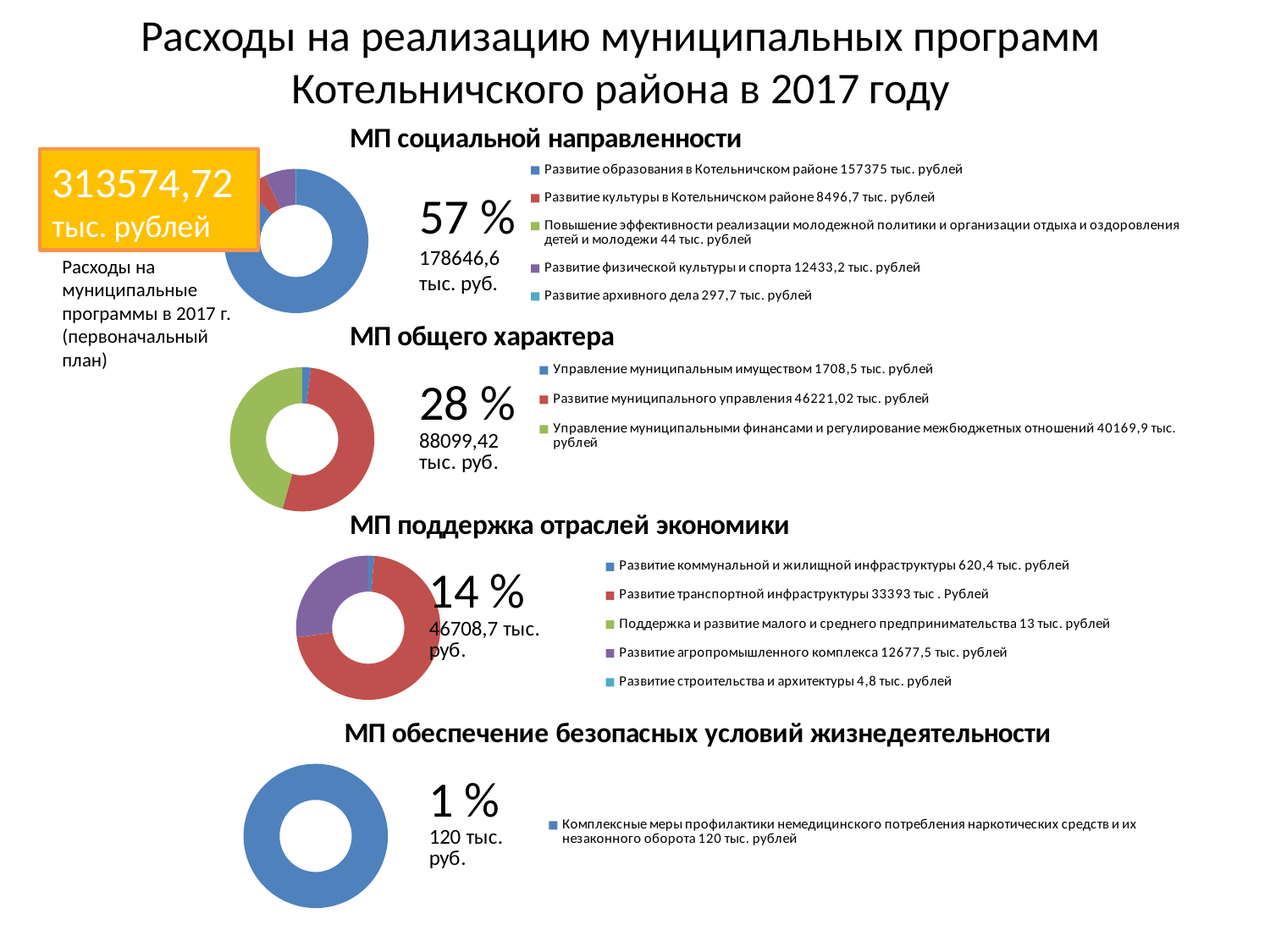
What total amount for municipal programmes in 2017 is shown in the orange box on the slide? 313574,72 тыс. рублей How many categories does the "МП поддержка отраслей экономики" chart list in its legend? 5 In the "МП социальной направленности" chart, which legend entry has the smallest value? Повышение эффективности реализации молодежной политики и организации отдыха и оздоровления детей и молодежи (44 тыс. рублей) What total amount is shown next to the "МП обеспечение безопасных условий жизнедеятельности" chart? 120 тыс. руб. In the "МП поддержка отраслей экономики" chart, which legend entry has the largest value? Развитие транспортной инфраструктуры (33393 тыс. рублей) In the "МП социальной направленности" chart, what value is given for "Развитие образования в Котельничском районе"? 157375 тыс. рублей What kind of chart is used under the heading "МП социальной направленности"? Doughnut (pie) chart In the "МП общего характера" chart, which is larger: "Развитие муниципального управления" or "Управление муниципальными финансами и регулирование межбюджетных отношений"? Развитие муниципального управления In the "МП поддержка отраслей экономики" chart, what is the difference between "Развитие коммунальной и жилищной инфраструктуры" (620,4) and "Развитие строительства и архитектуры" (4,8)? 615,6 тыс. рублей What percentage share is shown next to the "МП общего характера" chart? 28 % How many legend entries does the "МП социальной направленности" chart list? 5 In the "МП общего характера" chart, what value is given for "Развитие муниципального управления"? 46221,02 тыс. рублей